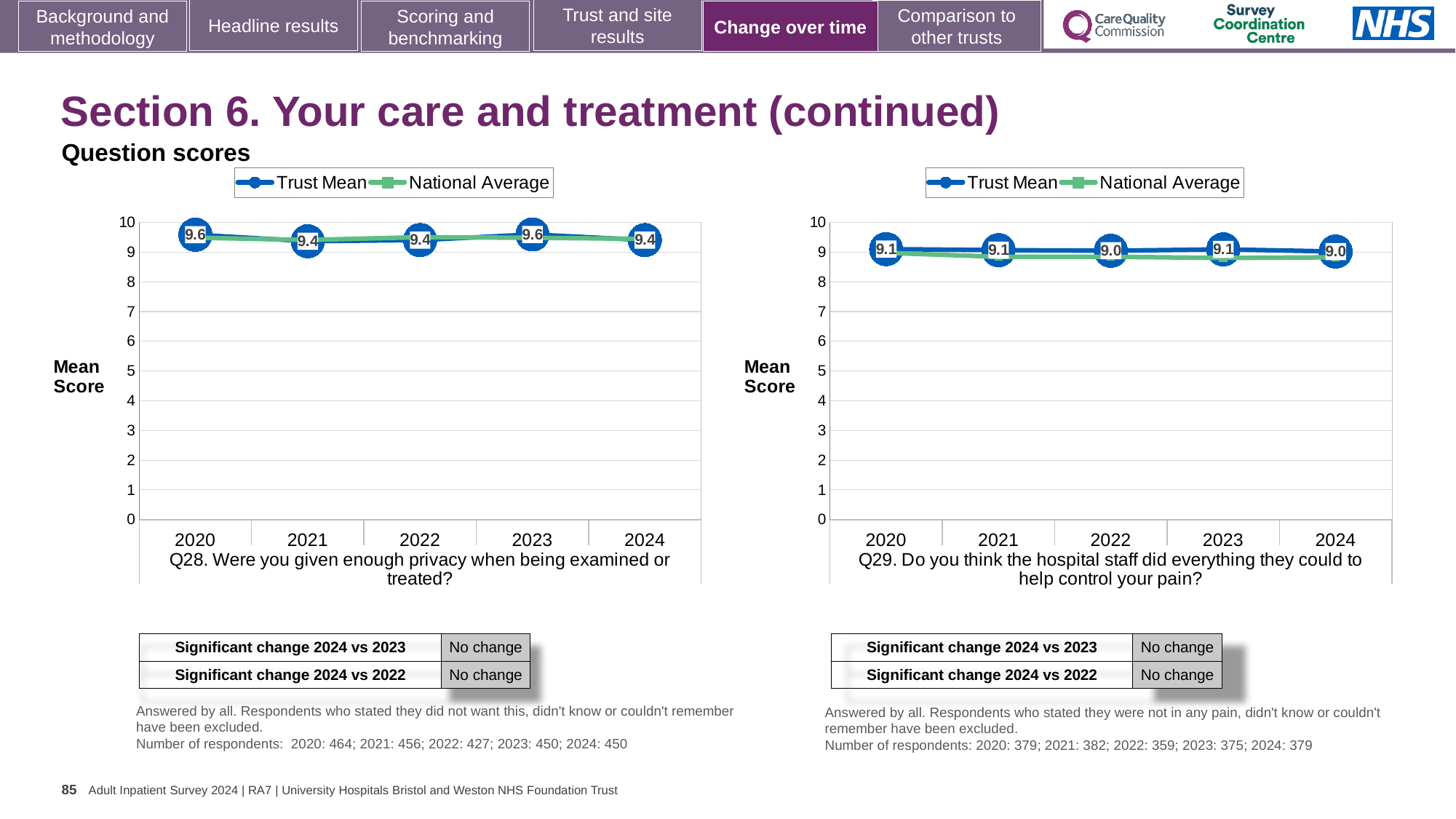
In the Q29 chart (right), what is the Trust Mean score for 2022? 9.0 In the Q29 chart (right), what is the difference between the Trust Mean scores for 2020 and 2024? 0.1 What are the two series named in the legend of the Q28 chart (left)? Trust Mean and National Average In the Q28 chart (left), what is the difference between the Trust Mean scores for 2023 and 2024? 0.2 How many years are plotted on the x axis of the Q28 chart (left)? 5 What kind of chart is the Q28 chart (left)? Line chart How many series does the legend of the Q29 chart (right) list? 2 In the Q28 chart (left), which year has the larger Trust Mean score, 2021 or 2023? 2023 In the Q29 chart (right), is the National Average for 2024 greater or less than 8? greater In the Q28 chart (left), what is the Trust Mean score for 2020? 9.6 In the Q29 chart (right), what is the Trust Mean score for 2023? 9.1 In the Q28 chart (left), what is the Trust Mean score for 2024? 9.4